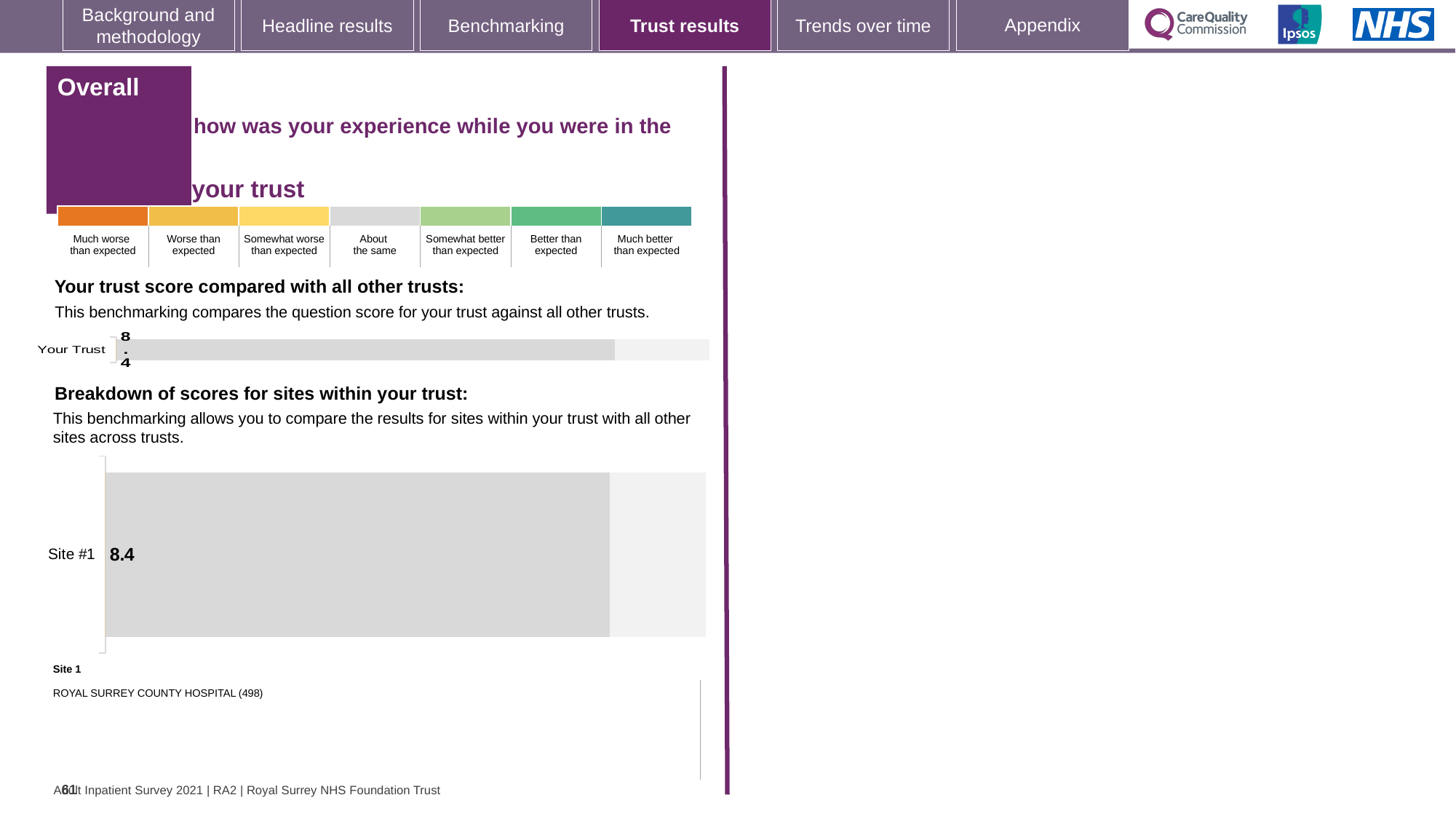
What kind of chart is the 'Breakdown of scores for sites within your trust' chart? bar chart What kind of chart is the 'Your trust score compared with all other trusts' chart? bar chart In the 'Your trust score compared with all other trusts' chart, what is the value for Your Trust? 8.4 Is the value for Your Trust in the 'Your trust score compared with all other trusts' chart larger than, smaller than, or equal to the value for Site #1 in the 'Breakdown of scores for sites within your trust' chart? equal What is the difference between the Your Trust score and the Site #1 score on this slide? 0 In the 'Breakdown of scores for sites within your trust' chart, what is the value for Site #1? 8.4 How many categories are shown in the 'Your trust score compared with all other trusts' chart? 1 How many bars are plotted in the 'Breakdown of scores for sites within your trust' chart? 1 What is the label of the only category in the 'Breakdown of scores for sites within your trust' chart? Site #1 According to the key below the site chart, which hospital is Site 1? ROYAL SURREY COUNTY HOSPITAL (498)